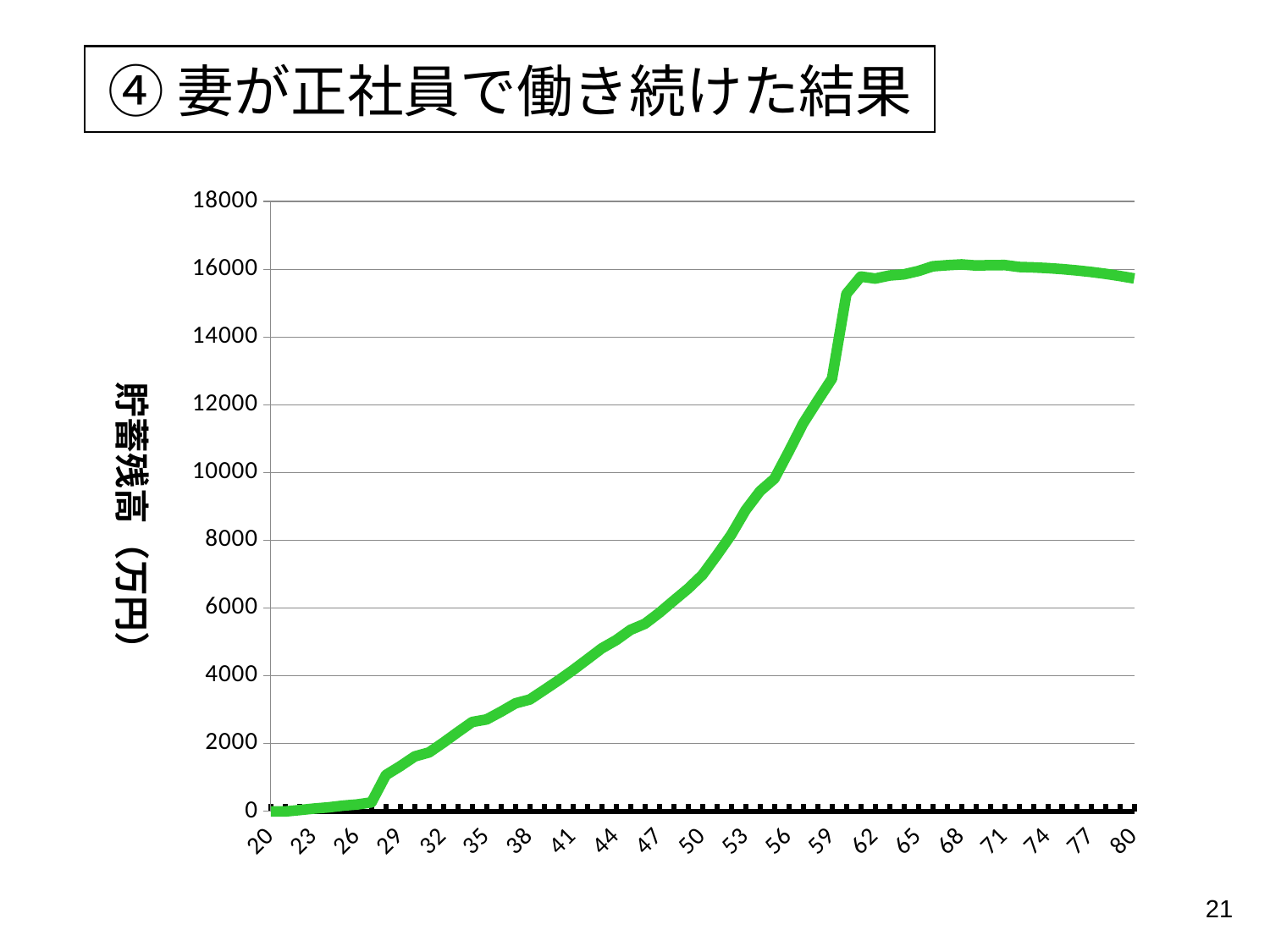
Does the line generally rise or fall between age 20 and age 62? rise Which is larger, the value at age 50 or the value at age 62? age 62 What kind of chart is shown on the slide? line chart Is the value at age 50 greater or less than 8000? less What is the label on the vertical axis of the chart? 貯蓄残高（万円） Is the value at age 59 greater or less than 12000? greater What is the title of the slide containing the chart? ④ 妻が正社員で働き続けた結果 Is the value at age 62 greater or less than 14000? greater At which age on the x axis is the plotted value lowest? 20 and 21